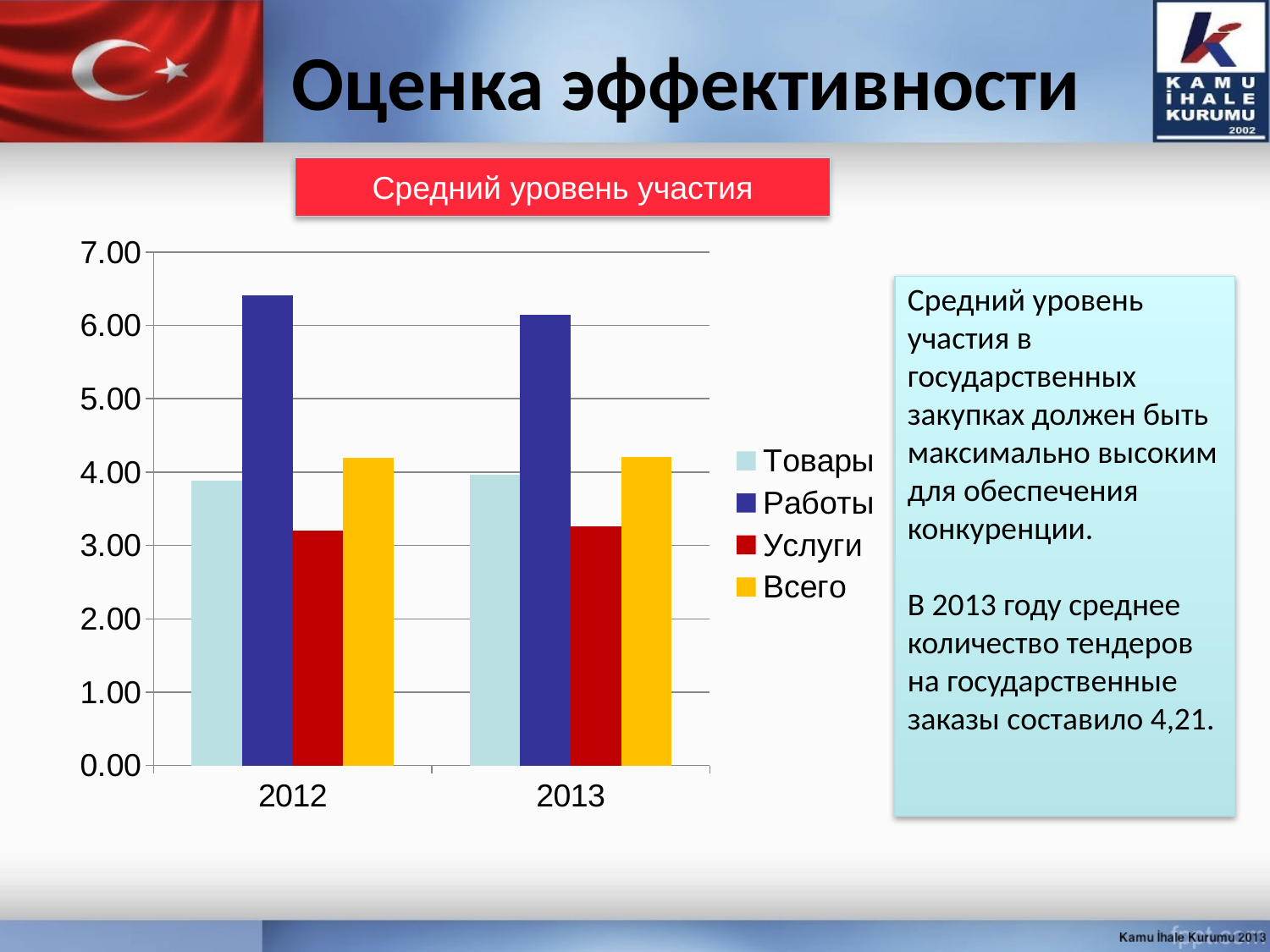
Which series has the highest value in 2012? Работы What colour represents the Всего series in the chart? yellow Which series has the lowest value in 2013? Услуги Which is larger: the value for Работы in 2012 or in 2013? 2012 What is the title shown above the chart? Средний уровень участия Is the value for Работы in 2012 greater or less than 6.00? greater Is the value for Товары in 2012 greater or less than 4.00? less How many year categories are shown on the x axis of the chart? 2 How many series does the chart legend list? 4 What kind of chart is shown on the slide? bar chart Is the value for Услуги in 2012 greater or less than 3.00? greater Does the value for Работы rise or fall from 2012 to 2013? fall